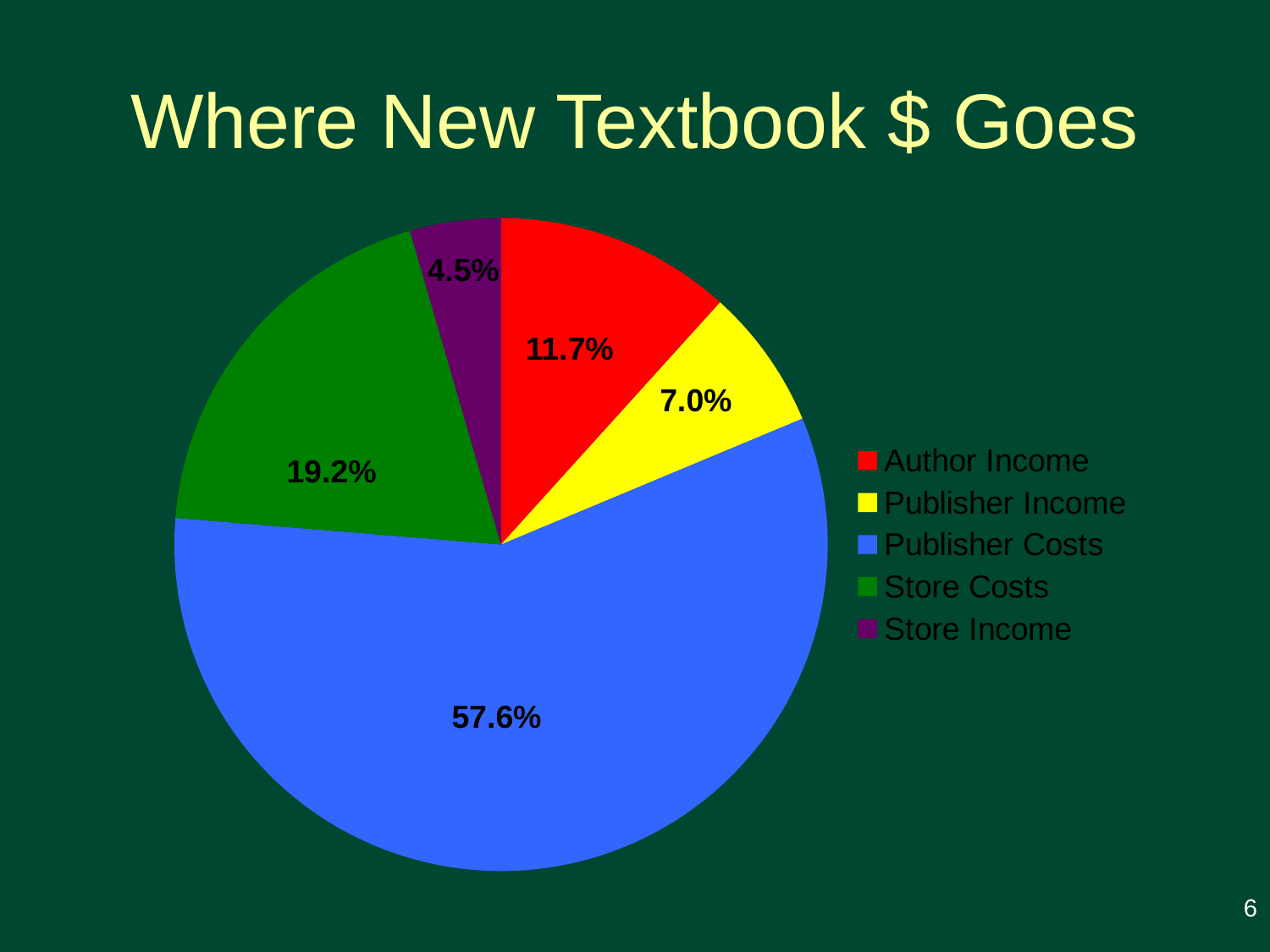
Which category has the smallest slice of the pie? Store Income What is the value shown for Store Income? 4.5% What is the value shown for Author Income? 11.7% What is the value shown for Store Costs? 19.2% What is the difference between Store Costs and Author Income? 7.5% What share of the pie does Publisher Costs take? 57.6% What is the value shown for Publisher Income? 7.0% What colour is the Store Costs slice? green Which category has the largest slice of the pie? Publisher Costs Which is larger, Author Income or Publisher Income? Author Income What type of chart is shown on the slide? pie chart How many categories does the pie chart have? 5